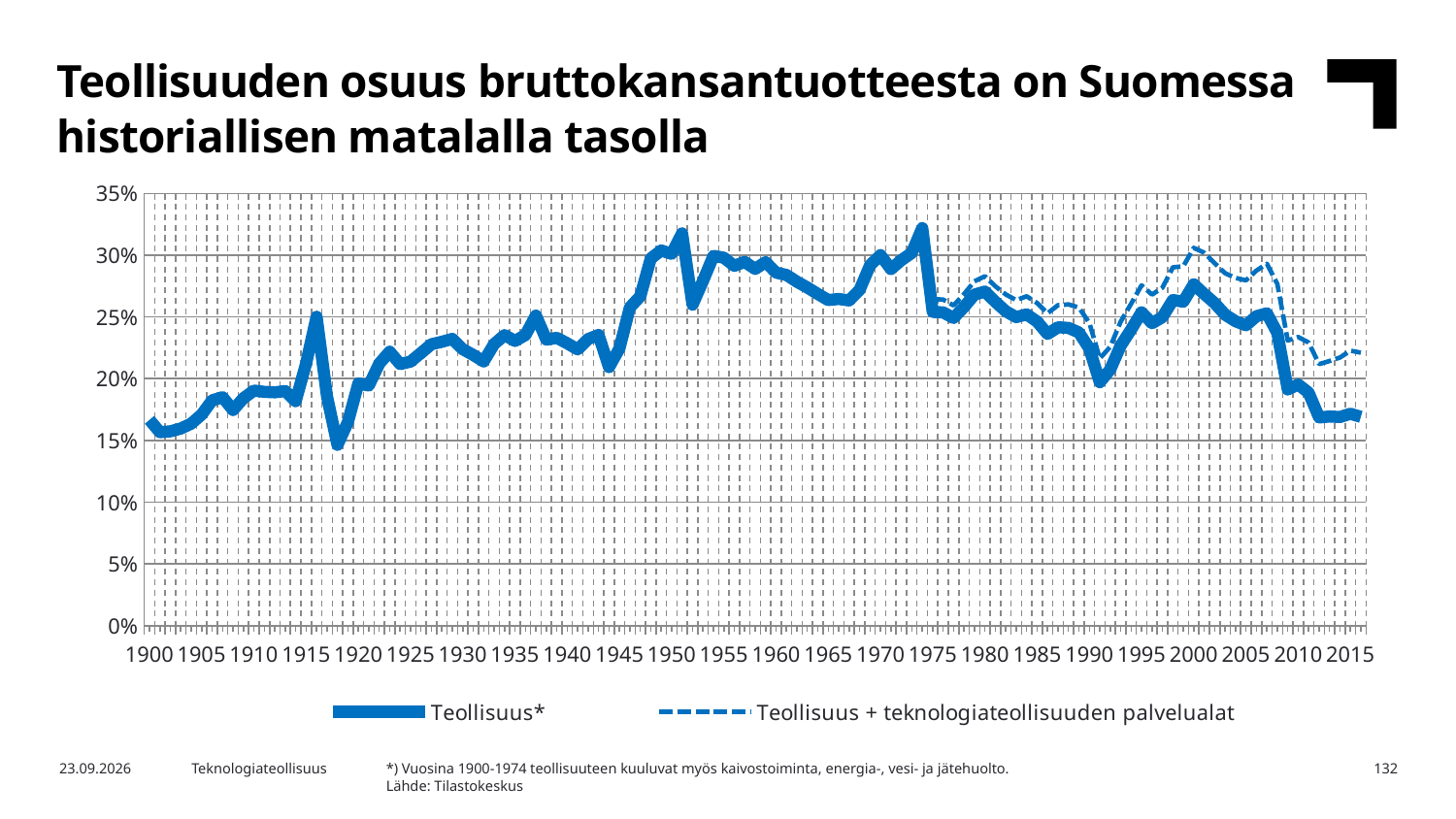
Does the Teollisuus* line rise or fall between 2005 and 2015? fall How many series does the legend list? 2 In 2015, which series has the higher value: Teollisuus* or Teollisuus + teknologiateollisuuden palvelualat? Teollisuus + teknologiateollisuuden palvelualat Is the value for Teollisuus* in 2015 greater or less than 20%? less What kind of chart is shown on the slide? line chart What is the highest value shown on the vertical axis? 35% Is the value for Teollisuus* in 1975 greater or less than 30%? less Is the value for Teollisuus* in 1965 greater or less than 25%? greater Which series is drawn with a dashed line? Teollisuus + teknologiateollisuuden palvelualat